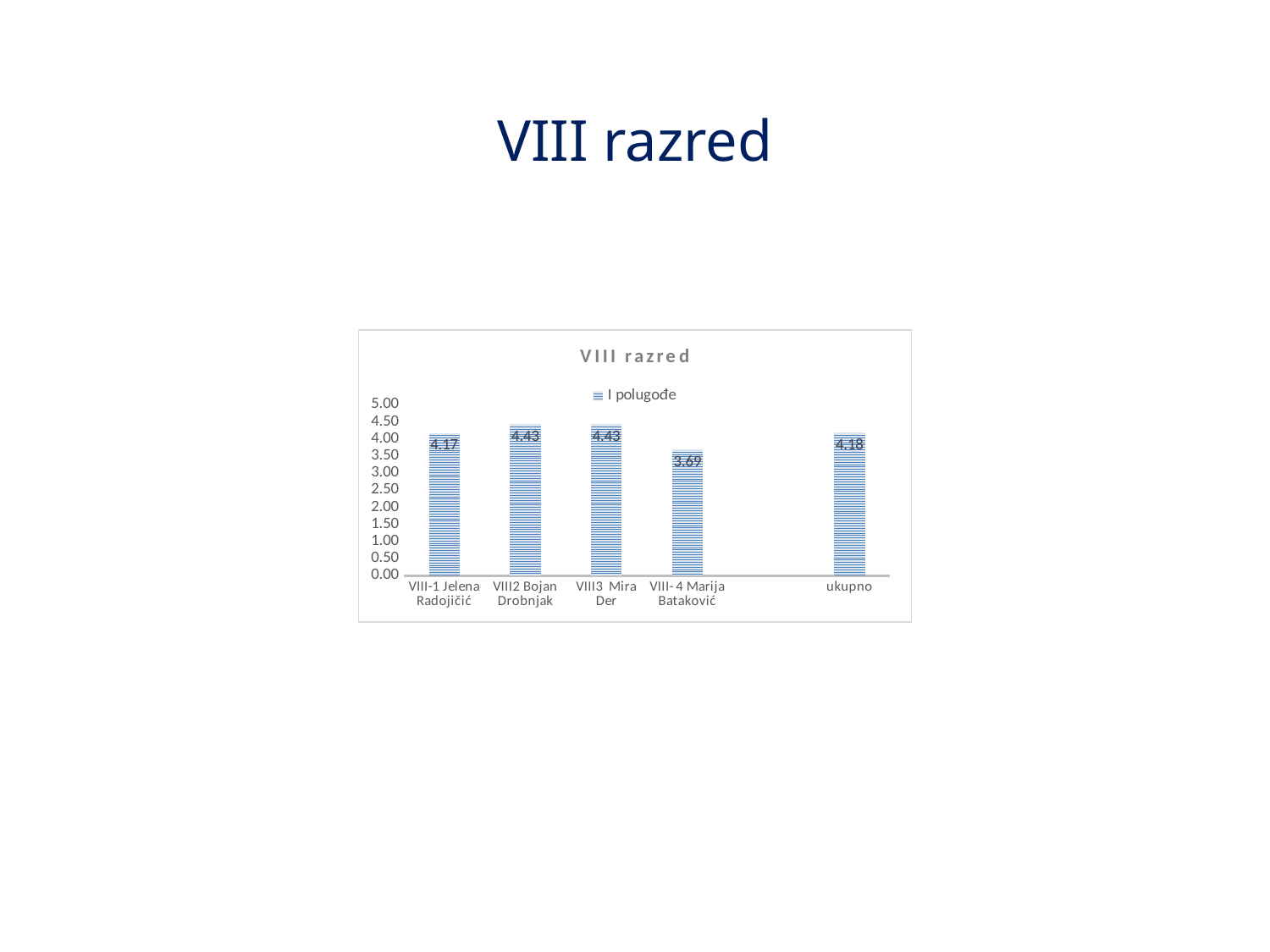
What is the difference between the values for VIII3 Mira Der and VIII-4 Marija Bataković? 0.74 What is the difference between the values for ukupno and VIII-1 Jelena Radojičić? 0.01 Which is larger, the value for VIII2 Bojan Drobnjak or the value for VIII-4 Marija Bataković? VIII2 Bojan Drobnjak What is the value for VIII2 Bojan Drobnjak? 4.43 What is the value for VIII-1 Jelena Radojičić? 4.17 Is the value for VIII-4 Marija Bataković greater or less than 4.00? less What is the value for ukupno? 4.18 Which category has the lowest value? VIII-4 Marija Bataković How many bars are plotted in the chart? 5 What is the value for VIII-4 Marija Bataković? 3.69 What type of chart is shown? bar chart What series name does the legend show? I polugođe